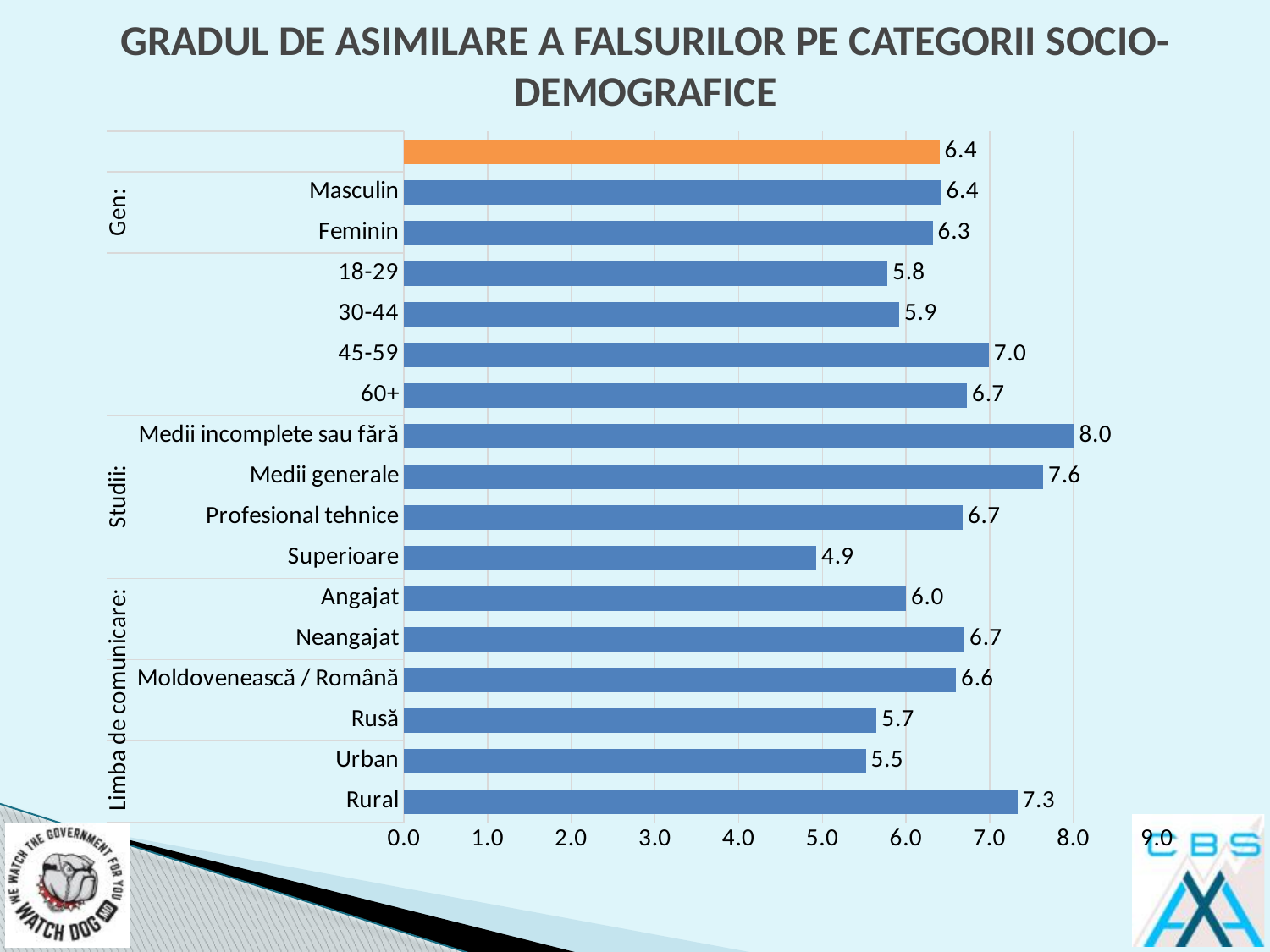
What kind of chart is shown on the slide? Bar chart Which is larger, the value for 18-29 or the value for 60+? 60+ What is the value for Neangajat? 6.7 What is the difference between the values for Rural and Urban? 1.8 What is the value for the 45-59 age group? 7.0 What colour is the topmost bar in the chart? Orange Which category has the lowest value? Superioare Which is larger, the value for Rusă or the value for Moldovenească / Română? Moldovenească / Română What is the value for Rural? 7.3 What is the difference between the values for Medii generale and Superioare? 2.7 Which category has the highest value? Medii incomplete sau fără What is the value for Superioare? 4.9